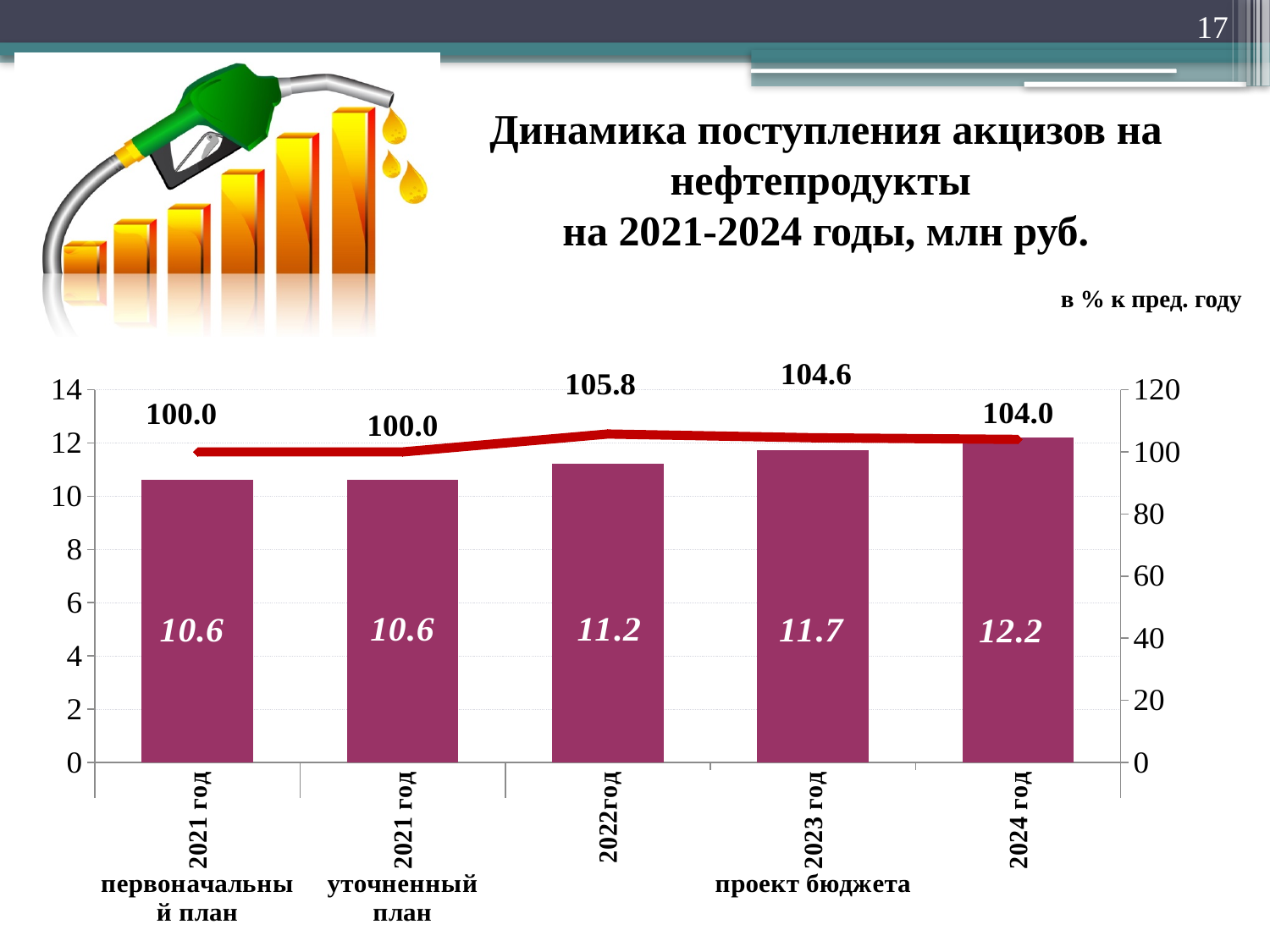
Which is larger, the bar value for 2023 год or for 2022 год? 2023 год What is the line value (в % к пред. году) for 2023 год? 104.6 What is the bar value for 2024 год? 12.2 What is the line value (в % к пред. году) for 2022 год? 105.8 Do the bar values rise or fall from 2022 год to 2024 год? rise What is the difference between the bar values for 2022 год and 2021 год (уточненный план)? 0.6 How many bars are plotted on the chart? 5 What is the title of the chart on the slide? Динамика поступления акцизов на нефтепродукты на 2021-2024 годы, млн руб. What is the bar value for 2022 год? 11.2 Which category has the highest line value (в % к пред. году)? 2022 год Which category has the highest bar value? 2024 год What is the difference between the bar values for 2024 год and 2023 год? 0.5